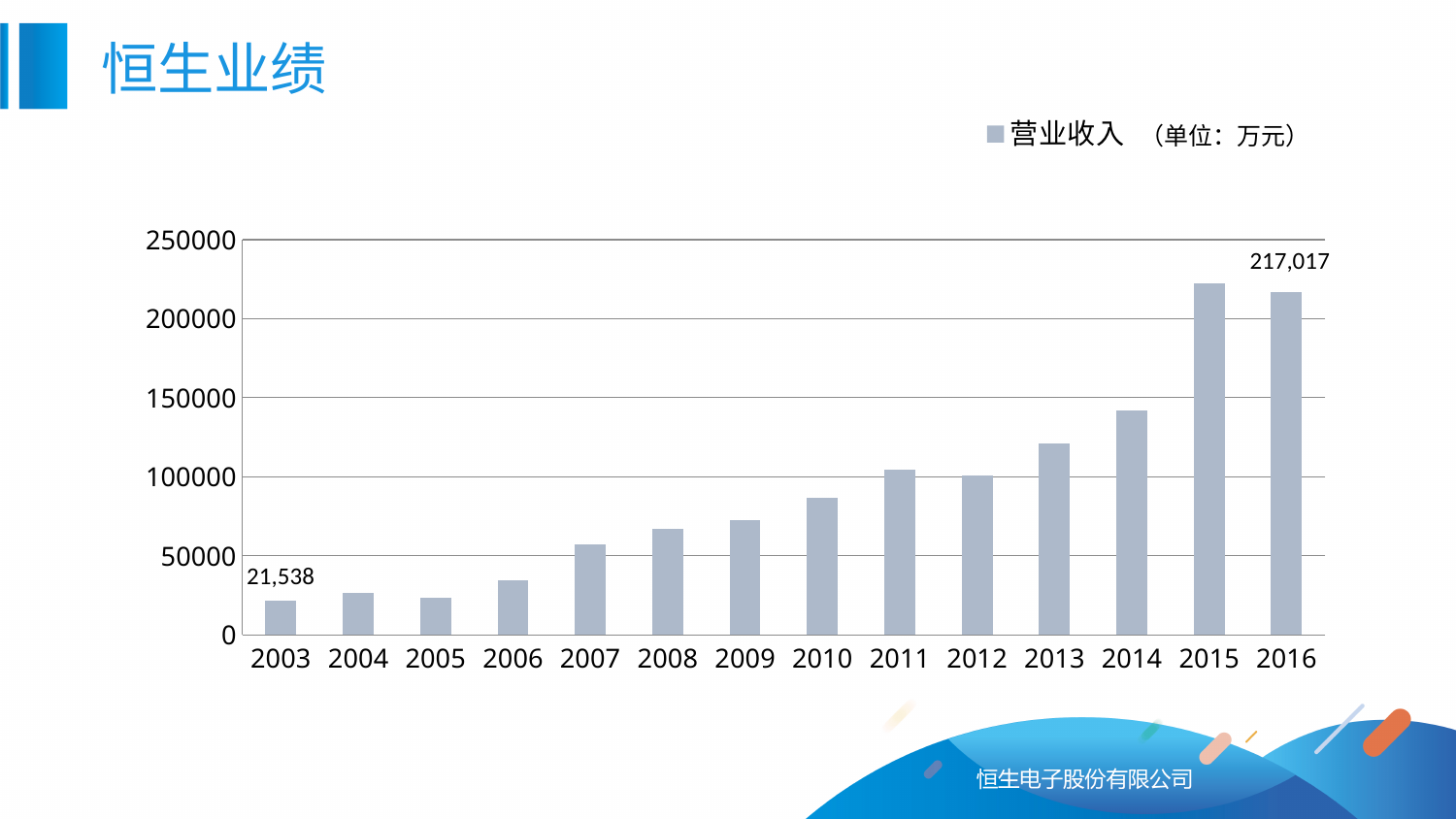
What kind of chart is shown on the slide? bar chart Is the value for 2006 greater or less than 50000? less Which is larger, the value for 2006 or the value for 2008? 2008 How many years are shown on the x axis? 14 What is the value for 2003? 21,538 What is the value for 2016? 217,017 Is the value for 2010 greater or less than 100000? less What unit is given in the legend for 营业收入? 万元 Is the value for 2014 greater or less than 150000? less What is the difference between the values for 2016 and 2003? 195,479 Which is larger, the value for 2013 or the value for 2014? 2014